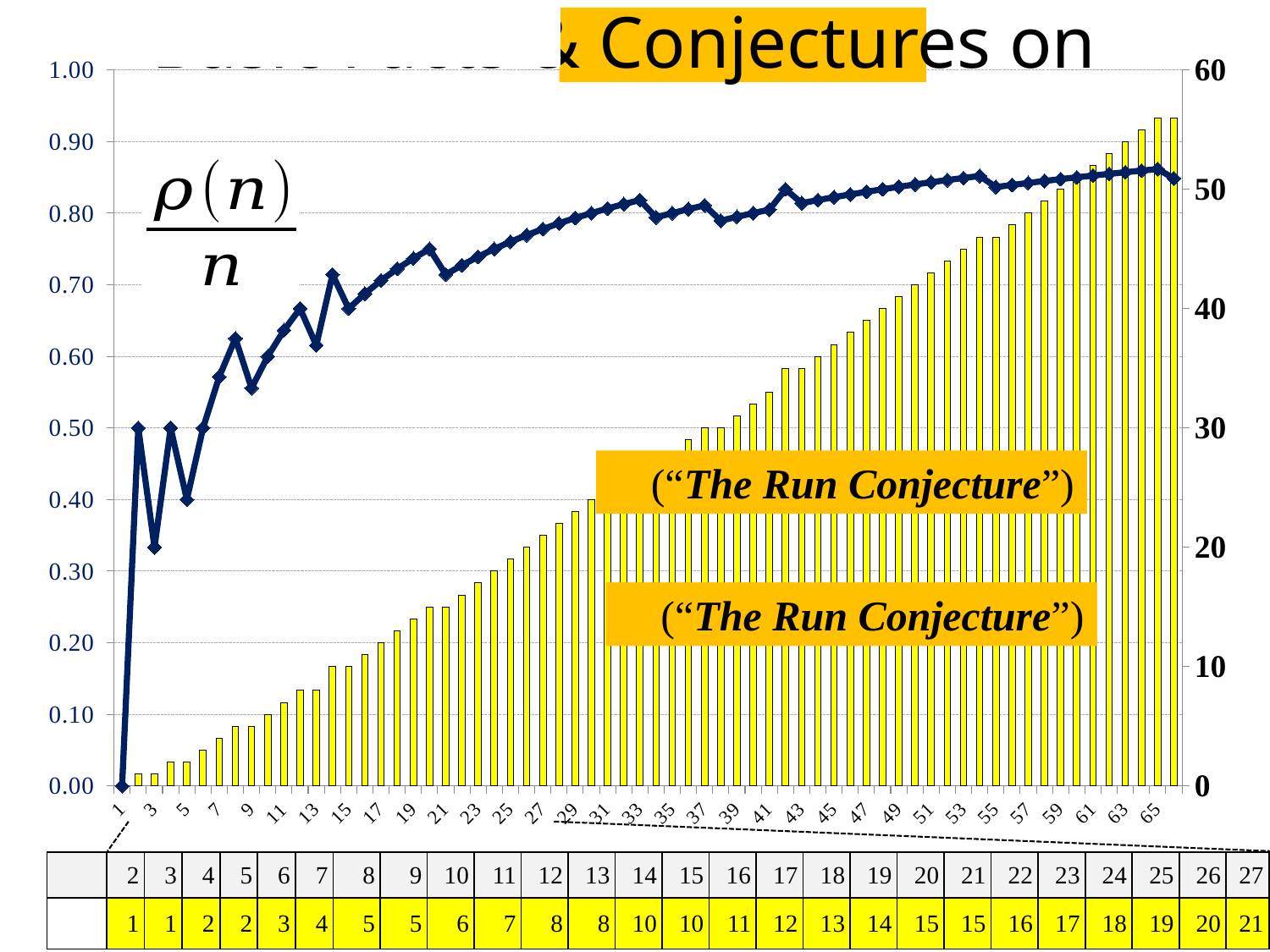
According to the data table below the chart, what is the bar value for n = 14? 10 Do the yellow bars generally rise or fall as x increases? rise Is the value of the line series at x = 60 greater or less than 0.80? greater What is the value of the line series at x = 4? 0.50 What kind of chart is shown on the slide? A combined bar and line chart At which x value is the line series at its lowest? 1 What is the maximum value shown on the right-hand vertical axis? 60 What is the value of the line series at x = 1? 0.00 What is the value of the line series at x = 2? 0.50 According to the data table below the chart, what is the bar value for n = 27? 21 Is the bar value at x = 40 greater or less than 30 on the right-hand axis? greater Is the value of the line series at x = 20 greater or less than 0.70? greater